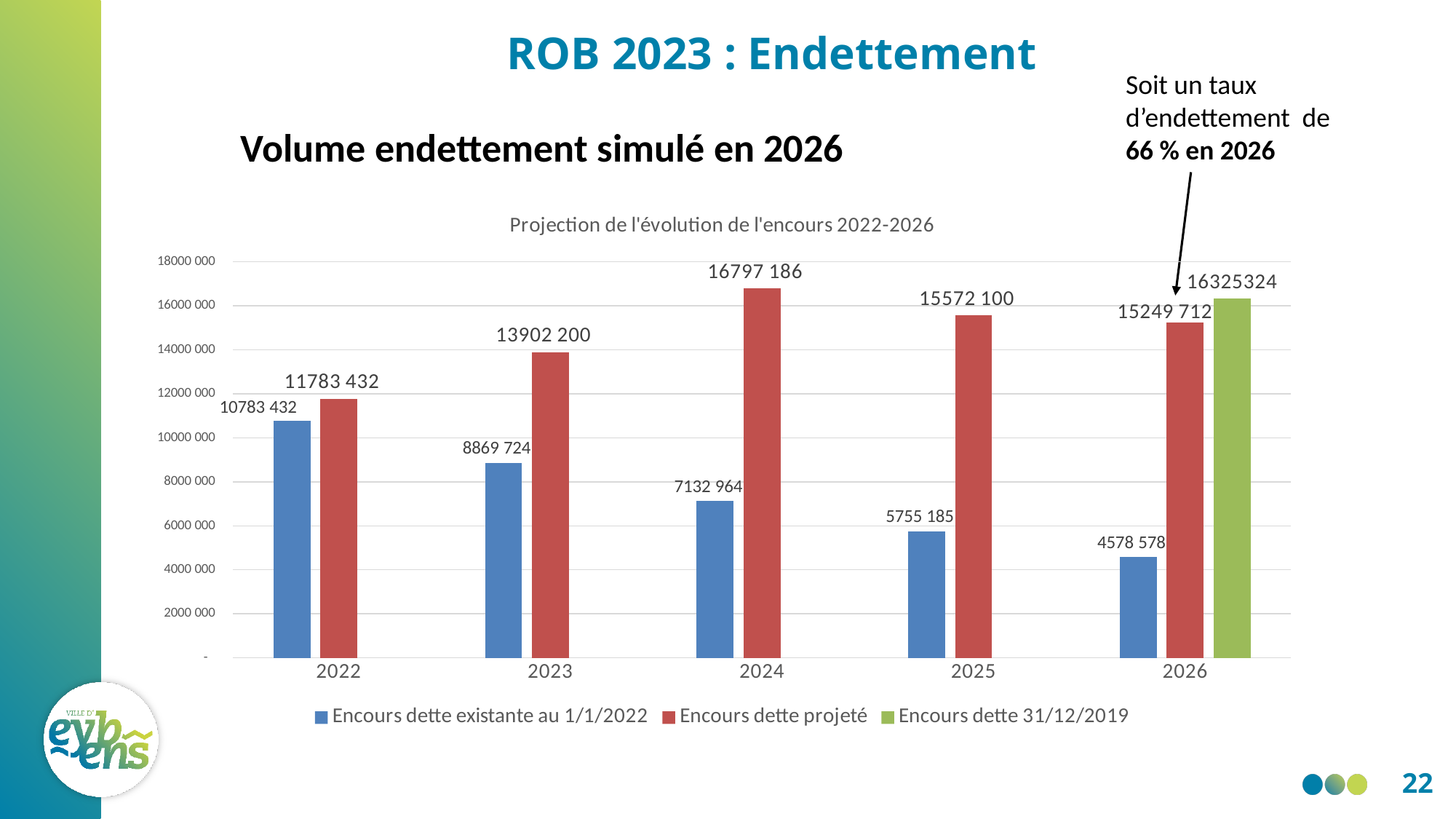
In which year is Encours dette existante au 1/1/2022 lowest? 2026 How many series does the chart legend list? 3 What is the value of Encours dette 31/12/2019 shown for 2026? 16325324 How many years are shown on the x axis of the chart? 5 Is the value of Encours dette existante au 1/1/2022 for 2024 greater or less than 8000 000? less What is the value of Encours dette projeté for 2024? 16797 186 Does Encours dette existante au 1/1/2022 rise or fall from 2022 to 2026? fall What is the difference between Encours dette projeté and Encours dette existante au 1/1/2022 in 2022? 1000 000 What is the value of Encours dette existante au 1/1/2022 for 2026? 4578 578 What is the difference between Encours dette projeté in 2024 and in 2025? 1225 086 In which year is Encours dette projeté highest? 2024 In 2026, which is larger: Encours dette projeté or Encours dette 31/12/2019? Encours dette 31/12/2019